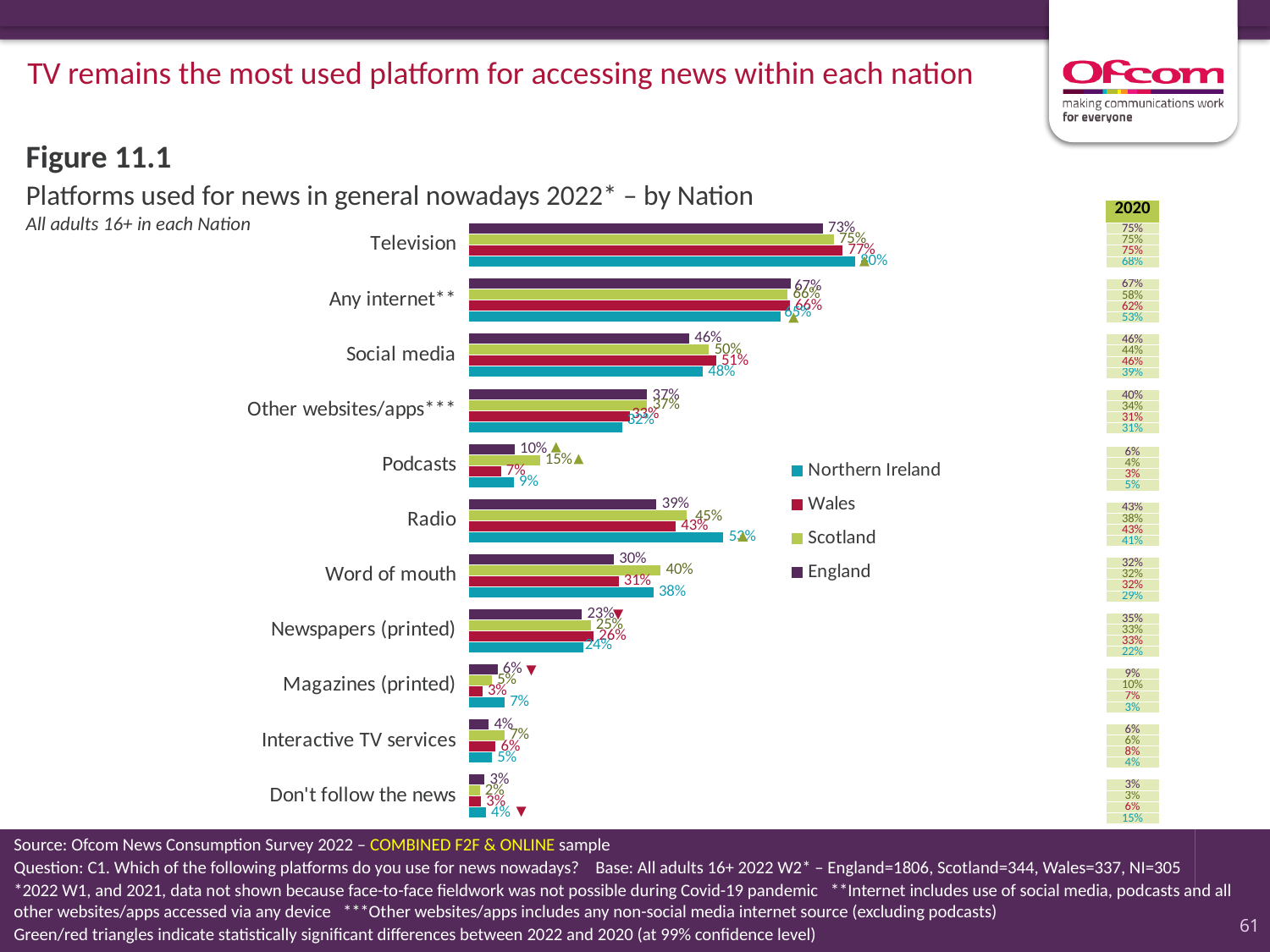
Which nation has the highest value for Radio? Northern Ireland How many nations (series) does the legend of the chart list? 4 What is the difference between Scotland's and England's values for Word of mouth? 10 percentage points What kind of chart is used in Figure 11.1? Bar chart For Social media, which is larger: the value for Wales or the value for England? Wales Which nation has the lowest value for Podcasts? Wales What percentage of adults in Scotland use social media for news? 50% What is the value for Radio in Northern Ireland? 53% Which nation is represented by the purple bars in the chart? England How many platform categories are shown on the chart? 11 What percentage of adults in Scotland use word of mouth for news? 40% What is the value for Podcasts in England? 10%